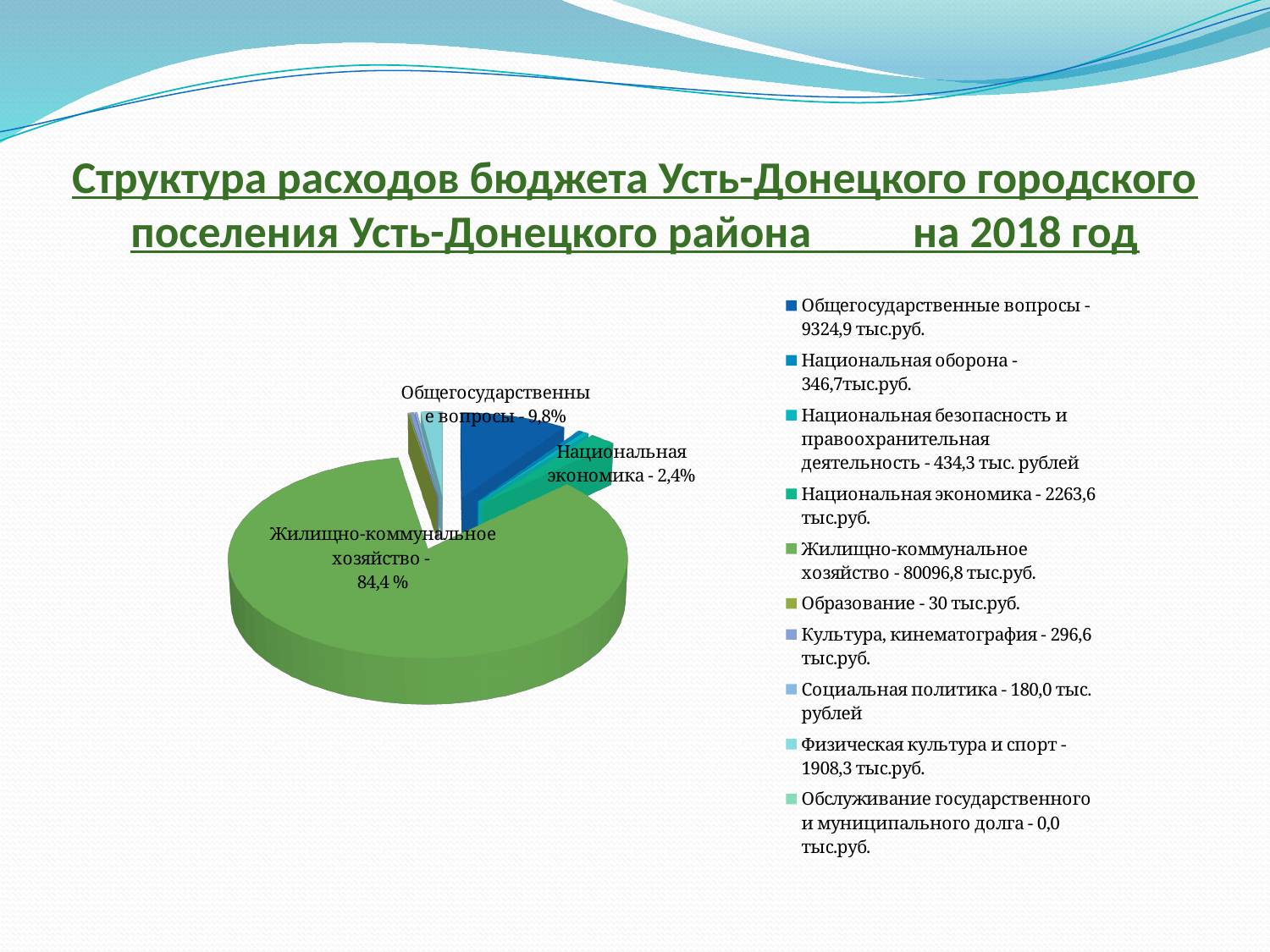
Which is larger according to the legend: Культура, кинематография or Социальная политика? Культура, кинематография What kind of chart is shown on the slide? pie chart What is the difference between the legend values for Общегосударственные вопросы and Национальная экономика? 7061,3 тыс.руб. How many categories does the legend of the pie chart list? 10 According to the legend, what is the value for Образование? 30 тыс.руб. Which category has the largest slice of the pie? Жилищно-коммунальное хозяйство What share of the pie does Жилищно-коммунальное хозяйство have? 84,4 % What share of the pie does Национальная экономика have? 2,4% Which category has the smallest value in the legend? Обслуживание государственного и муниципального долга According to the legend, what is the value for Физическая культура и спорт? 1908,3 тыс.руб. What share of the pie does Общегосударственные вопросы have? 9,8% According to the legend, what is the value for Национальная оборона? 346,7 тыс.руб.